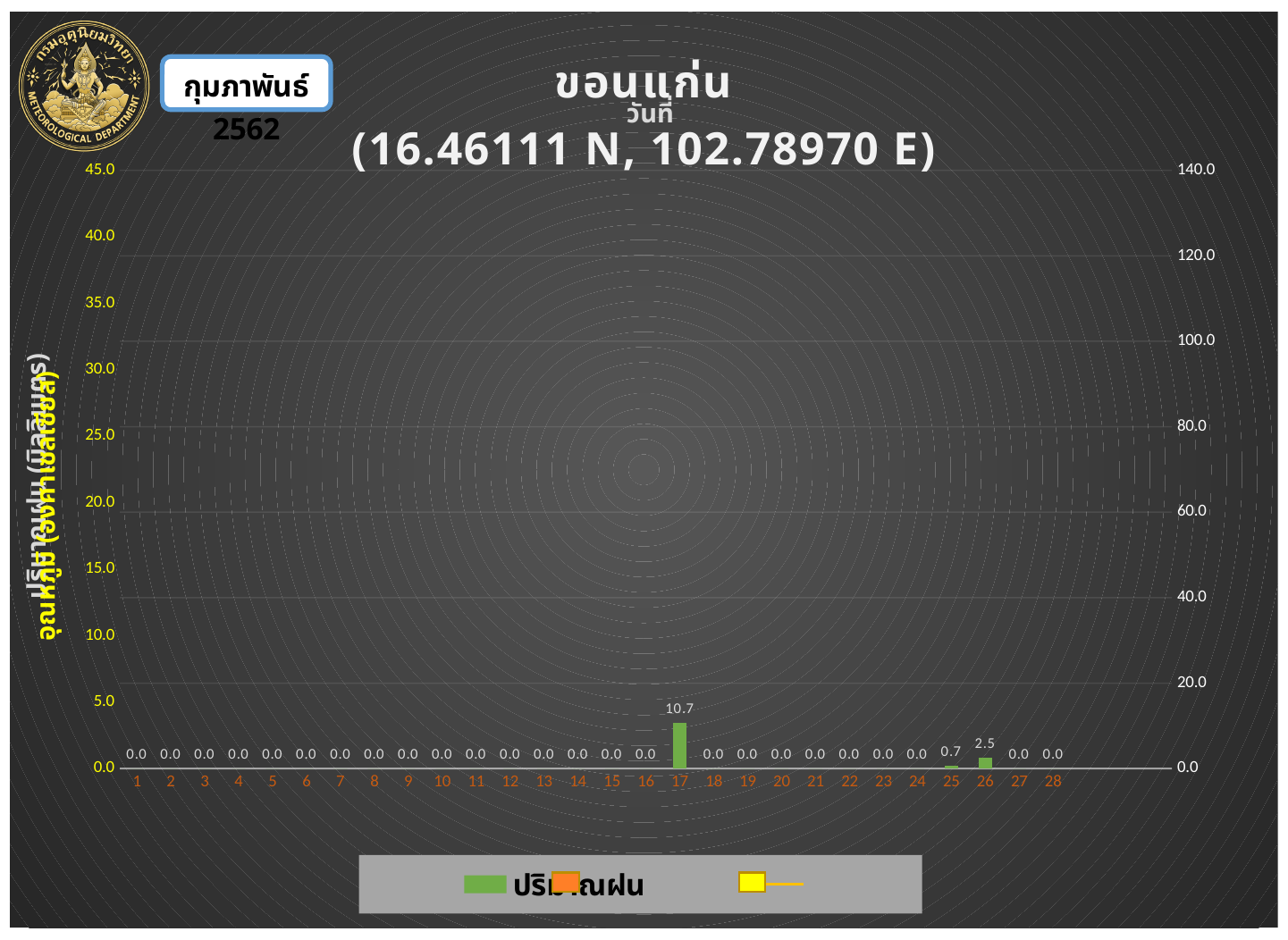
Which is larger, the rainfall value for day 25 or for day 26? day 26 What is the rainfall value shown for day 17? 10.7 What is the rainfall value shown for day 26? 2.5 What are the coordinates shown in the chart title? 16.46111 N, 102.78970 E What is the rainfall value shown for day 25? 0.7 What kind of chart is used to show the rainfall values? bar chart What is the rainfall value shown for day 10? 0.0 What is the difference between the rainfall values for day 17 and day 26? 8.2 How many days are shown on the x axis? 28 What is the difference between the rainfall values for day 26 and day 25? 1.8 Which day has the highest rainfall value? 17